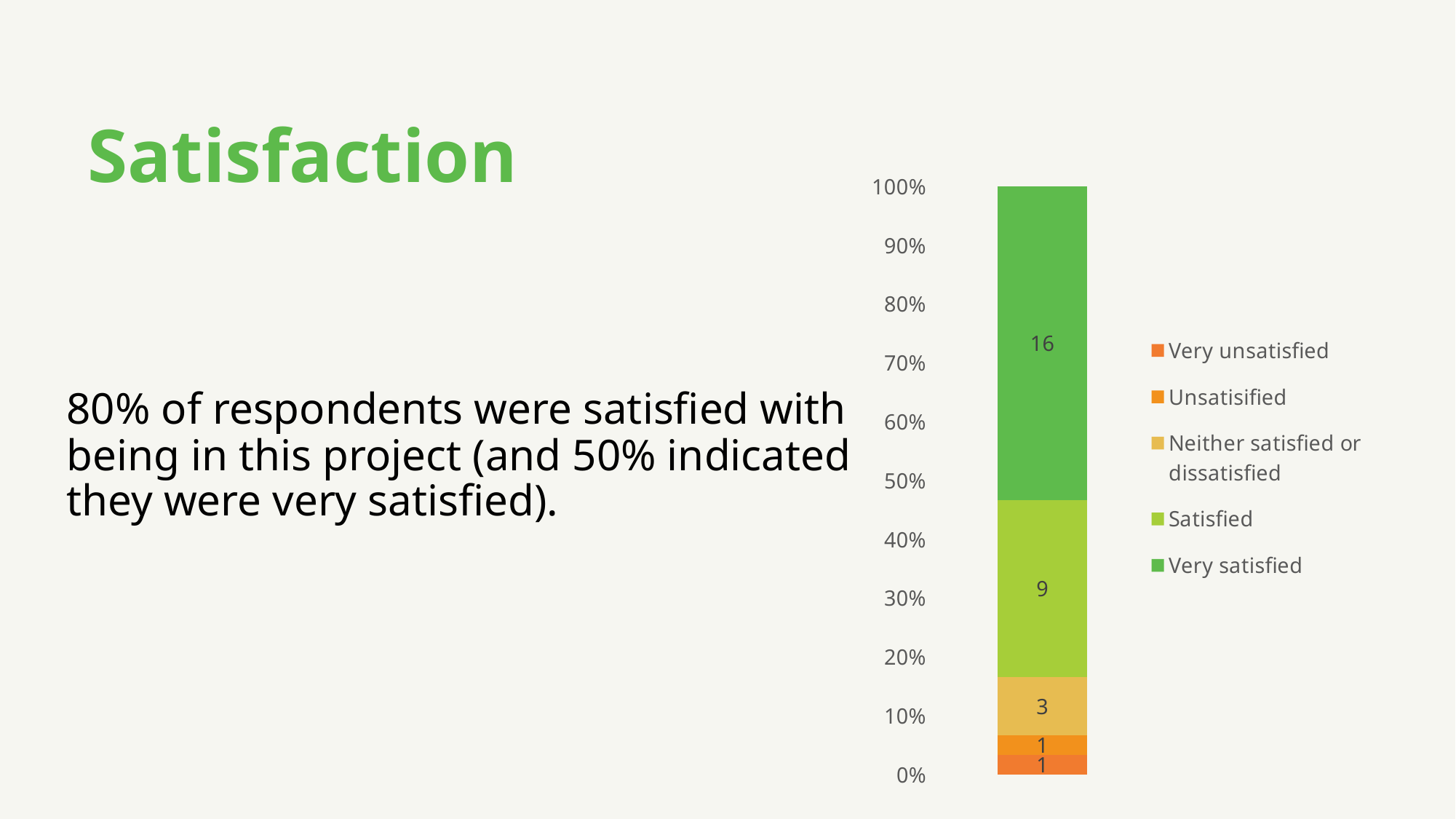
What value is shown for the Very satisfied segment? 16 What kind of chart is shown on the slide? Stacked bar chart How many series does the legend list? 5 Is the top of the Satisfied segment greater or less than 40% on the axis? greater What value is shown for the Very unsatisfied segment? 1 What colour is the Very satisfied segment? Green Which segment has the highest value? Very satisfied What is the difference between the Very satisfied and Satisfied values? 7 Which is larger, the Satisfied value or the Neither satisfied or dissatisfied value? Satisfied What is the total of all segments in the stacked bar? 30 What value is shown for the Satisfied segment? 9 What value is shown for the Neither satisfied or dissatisfied segment? 3